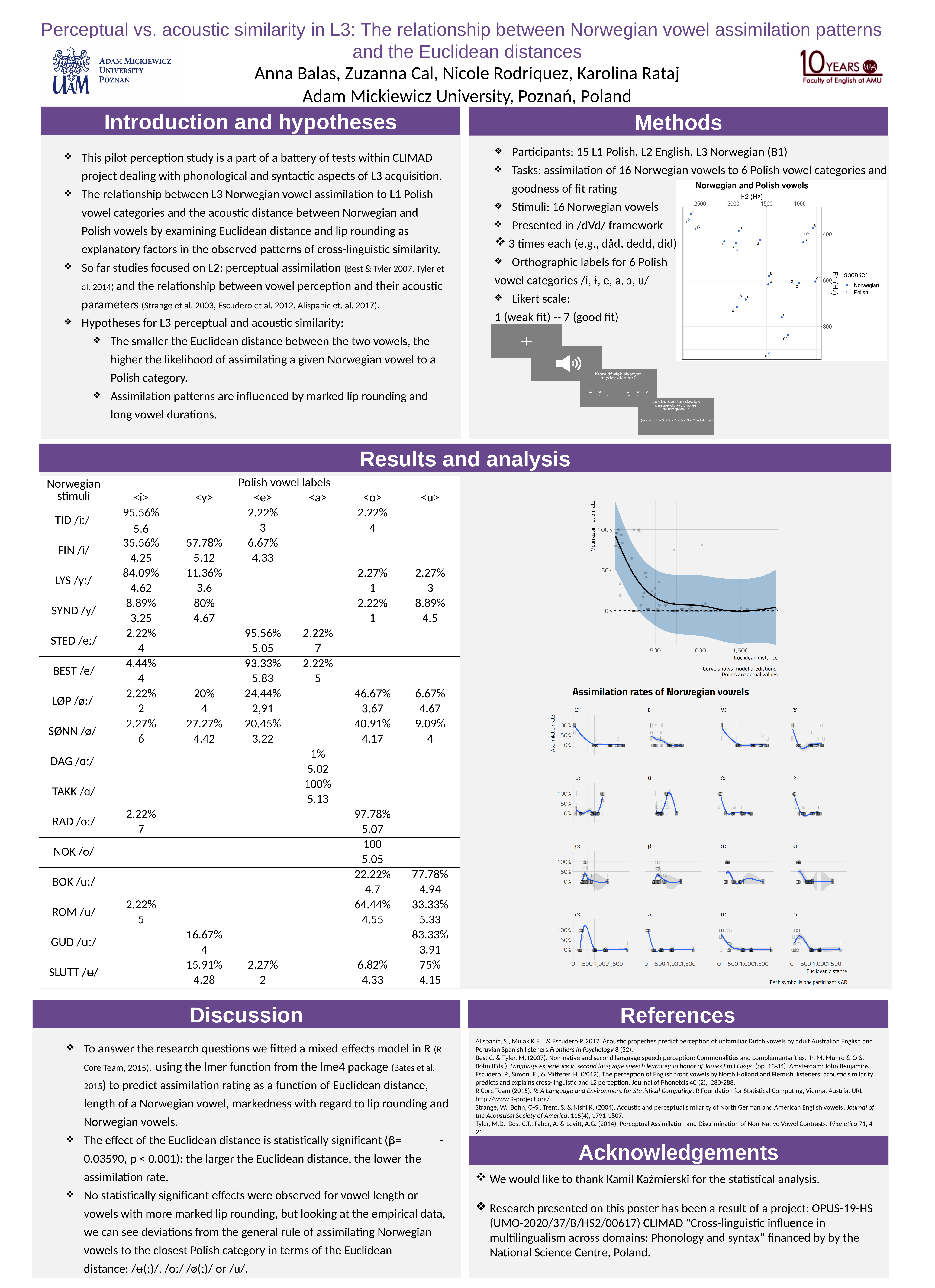
In the chart of mean assimilation rate against Euclidean distance (top right of Results), does the model curve rise or fall as Euclidean distance increases? fall In the 'Norwegian and Polish vowels' chart, is the F1 value of the Norwegian vowel 'i:' greater or less than 400 Hz? less What kind of chart is the 'Norwegian and Polish vowels' chart in the Methods section? scatter plot In the 'Norwegian and Polish vowels' chart, is the F1 value of the Polish vowel 'a' greater or less than 800 Hz? greater What is the title of the faceted chart in the lower right of the Results section? Assimilation rates of Norwegian vowels In the chart of mean assimilation rate against Euclidean distance, is the model curve at a Euclidean distance of 1,500 greater or less than 50%? less How many speaker groups does the legend of the 'Norwegian and Polish vowels' chart list? 2 How many vowel panels does the 'Assimilation rates of Norwegian vowels' chart contain? 16 What is the title of the legend in the 'Norwegian and Polish vowels' chart? speaker